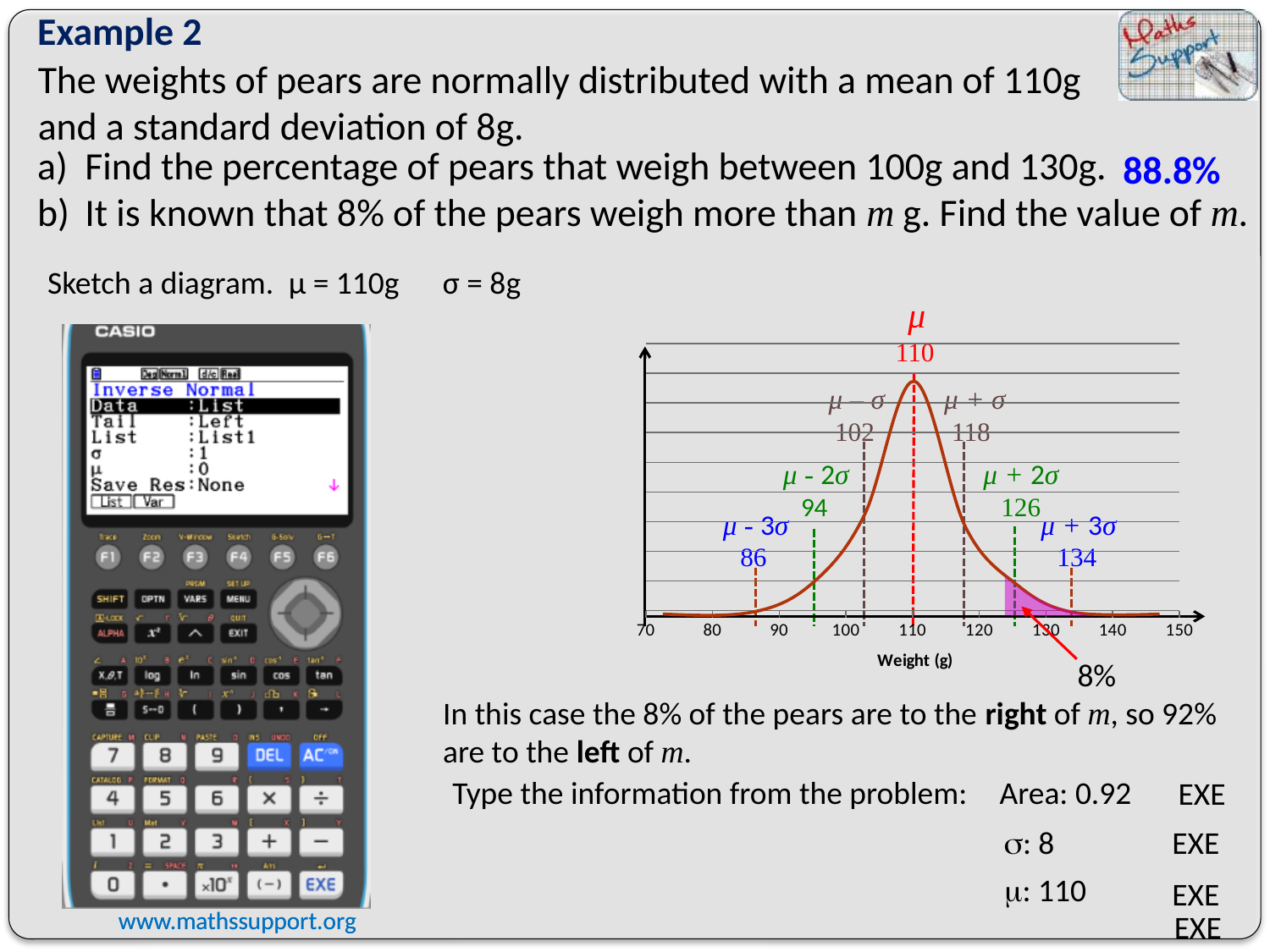
On the normal curve diagram, what percentage is written next to the shaded region in the right tail? 8% On the normal curve diagram, what value is labelled at μ − 3σ? 86 On the normal curve diagram, what value is labelled at μ + 2σ? 126 On the normal curve diagram, what value is labelled at μ − σ? 102 On the normal curve diagram, does the curve rise or fall as the weight increases from 110 to 150? Fall What is the title of the horizontal axis of the normal curve diagram? Weight (g) How many tick labels are shown on the horizontal axis of the normal curve diagram? 9 What kind of chart is the diagram on the right of the slide? A line chart (normal distribution curve) At which weight value does the normal curve reach its highest point? 110 On the normal curve diagram, is the curve higher at a weight of 110 or at a weight of 130? 110 On the normal curve diagram, what value is labelled at μ? 110 On the normal curve diagram, what is the difference between the values labelled at μ + σ and μ − σ? 16